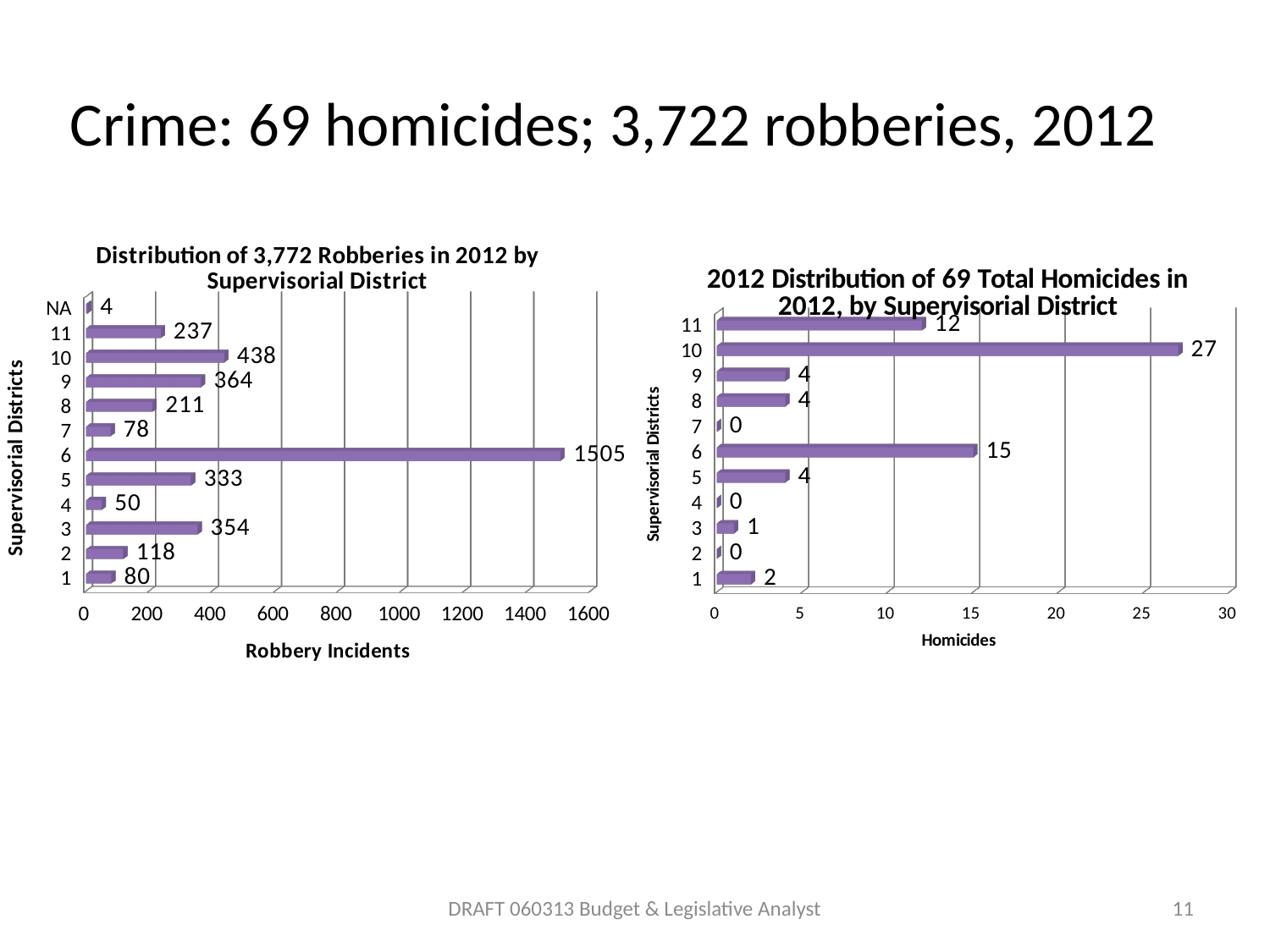
In the robberies chart, how many robbery incidents are shown for district 10? 438 In the homicides chart, how many homicides are shown for district 10? 27 In the homicides chart, how many homicides are shown for district 6? 15 In the robberies chart, which has more robbery incidents, district 3 or district 5? 3 In the robberies chart, which district has the lowest number of robbery incidents (excluding NA)? 4 What kind of chart is the homicides chart? Bar chart In the homicides chart, which district has the highest number of homicides? 10 In the robberies chart, how many categories are plotted on the vertical axis? 12 In the robberies chart, how many robbery incidents are shown for district 6? 1505 In the homicides chart, what is the difference in homicides between district 10 and district 11? 15 What is the x-axis label of the robberies chart? Robbery Incidents In the robberies chart, what is the difference in robbery incidents between district 9 and district 8? 153